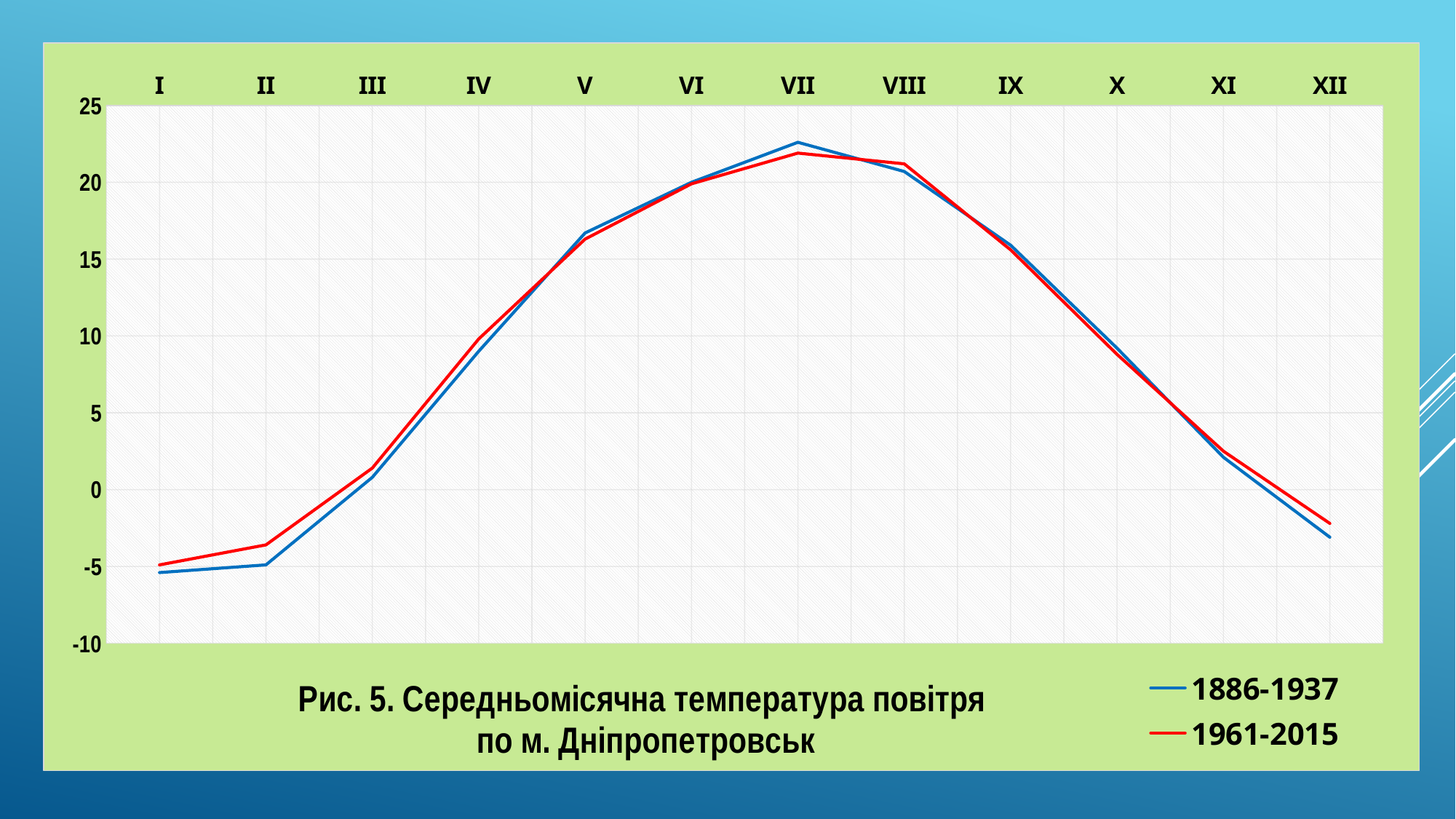
Is the value for the 1886-1937 series in month X greater or less than 5? greater What kind of chart is shown on the slide? Line chart How many months (categories) are plotted along the x axis? 12 In which month does the 1886-1937 series reach its highest value? VII What colour is the line for the 1961-2015 series? Red Is the value for the 1961-2015 series in month I greater or less than 0? less Is the value for the 1886-1937 series in month VII greater or less than 20? greater In which month does the 1886-1937 series have its lowest value? I In which month does the 1961-2015 series have its lowest value? I Do the values of the 1886-1937 series rise or fall from month I to month VII? rise In month II, which series has the higher value, 1886-1937 or 1961-2015? 1961-2015 How many series does the legend list? 2